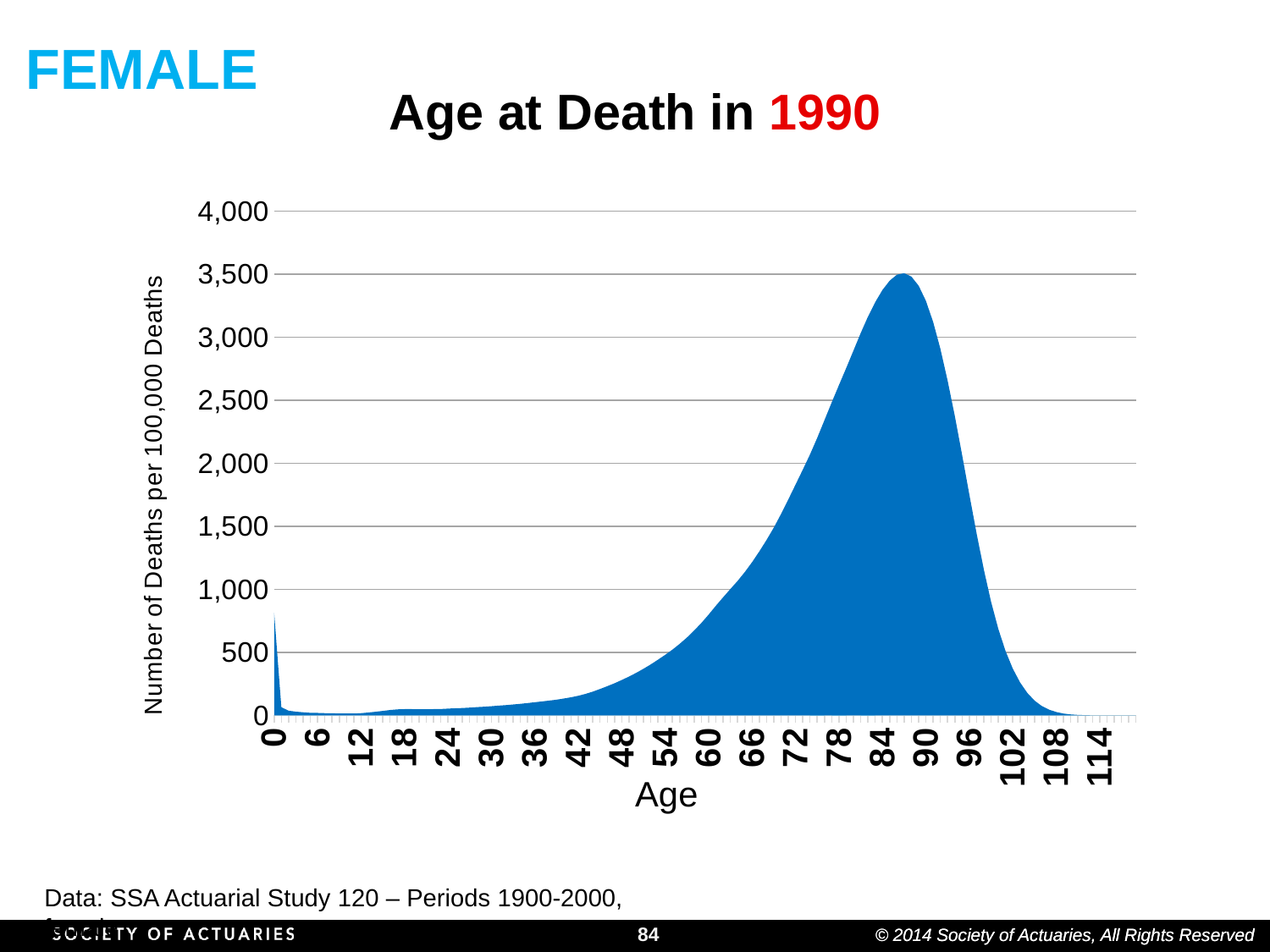
Do the values rise or fall as age increases from 90 to 108? fall What is the label of the vertical axis? Number of Deaths per 100,000 Deaths Is the peak value of the curve greater or less than 4,000? less Is the value at age 78 greater or less than the value at age 42? greater Do the values rise or fall as age increases from 60 to 84? rise What kind of chart is shown on the slide? area chart Is the peak value of the curve greater or less than 3,000? greater What is the title of the chart? Age at Death in 1990 Is the value at age 30 greater or less than 500? less